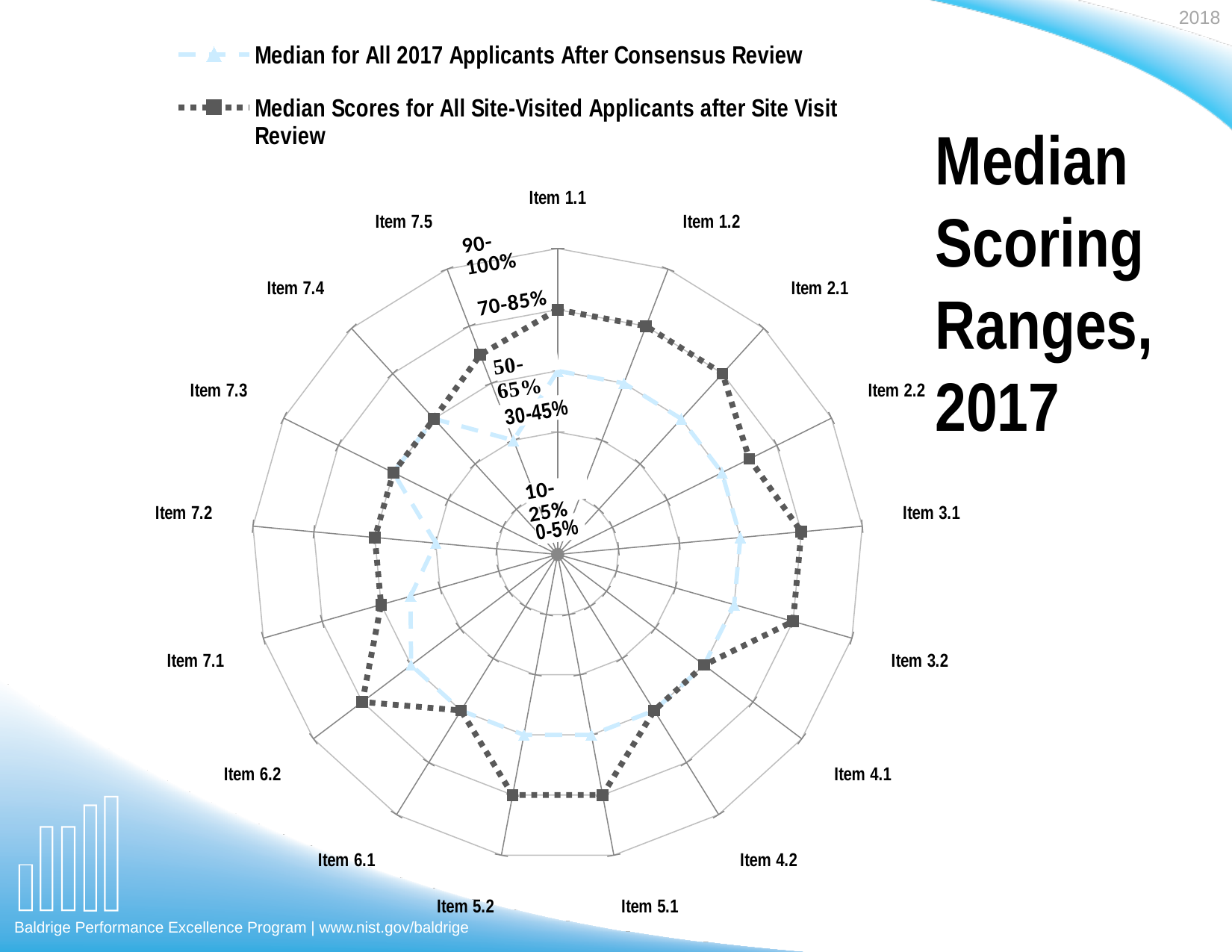
Which series is drawn with the dark dotted line and square markers? Median Scores for All Site-Visited Applicants after Site Visit Review For Item 7.1, which is higher: the site-visit median or the consensus-review median? Site-visit median Which scoring range does the consensus-review median for Item 1.1 fall in? 50-65% How many series does the legend list? 2 Which scoring range does the site-visit median for Item 3.1 fall in? 70-85% Which scoring range does the site-visit median for Item 1.1 fall in? 70-85% Which scoring range does the site-visit median for Item 6.1 fall in? 50-65% What is the title of the chart on the slide? Median Scoring Ranges, 2017 Which scoring range does the site-visit median for Item 7.2 fall in? 50-65% How many items (categories) are plotted around the radar chart? 17 For Item 2.2, which is higher: the site-visit median or the consensus-review median? Site-visit median What kind of chart is shown on the slide? Radar chart